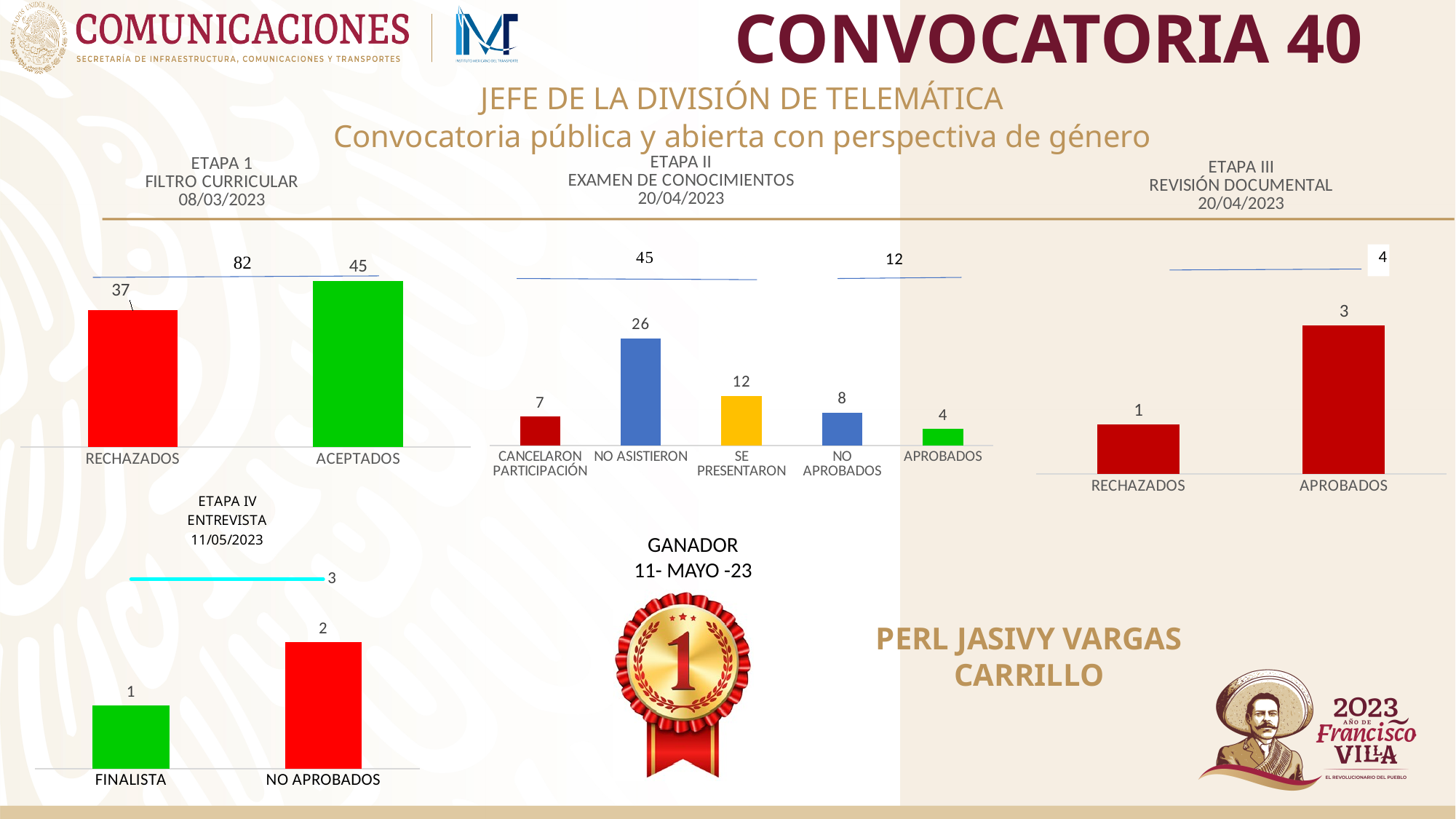
In the ETAPA II EXAMEN DE CONOCIMIENTOS chart, what is the value for SE PRESENTARON? 12 What kind of chart is the ETAPA IV ENTREVISTA chart? combination bar and line chart In the ETAPA 1 FILTRO CURRICULAR chart, what is the value for ACEPTADOS? 45 In the ETAPA III REVISIÓN DOCUMENTAL chart, what is the value for RECHAZADOS? 1 In the ETAPA II EXAMEN DE CONOCIMIENTOS chart, which category has the highest value? NO ASISTIERON In the ETAPA II EXAMEN DE CONOCIMIENTOS chart, which category has the lowest value? APROBADOS In the ETAPA 1 FILTRO CURRICULAR chart, what is the difference between ACEPTADOS and RECHAZADOS? 8 In the ETAPA II EXAMEN DE CONOCIMIENTOS chart, which is larger, NO APROBADOS or CANCELARON PARTICIPACIÓN? NO APROBADOS In the ETAPA IV ENTREVISTA chart, what is the value for NO APROBADOS? 2 In the ETAPA III REVISIÓN DOCUMENTAL chart, what is the value for APROBADOS? 3 In the ETAPA II EXAMEN DE CONOCIMIENTOS chart, how many categories are shown? 5 In the ETAPA 1 FILTRO CURRICULAR chart, what is the value for RECHAZADOS? 37